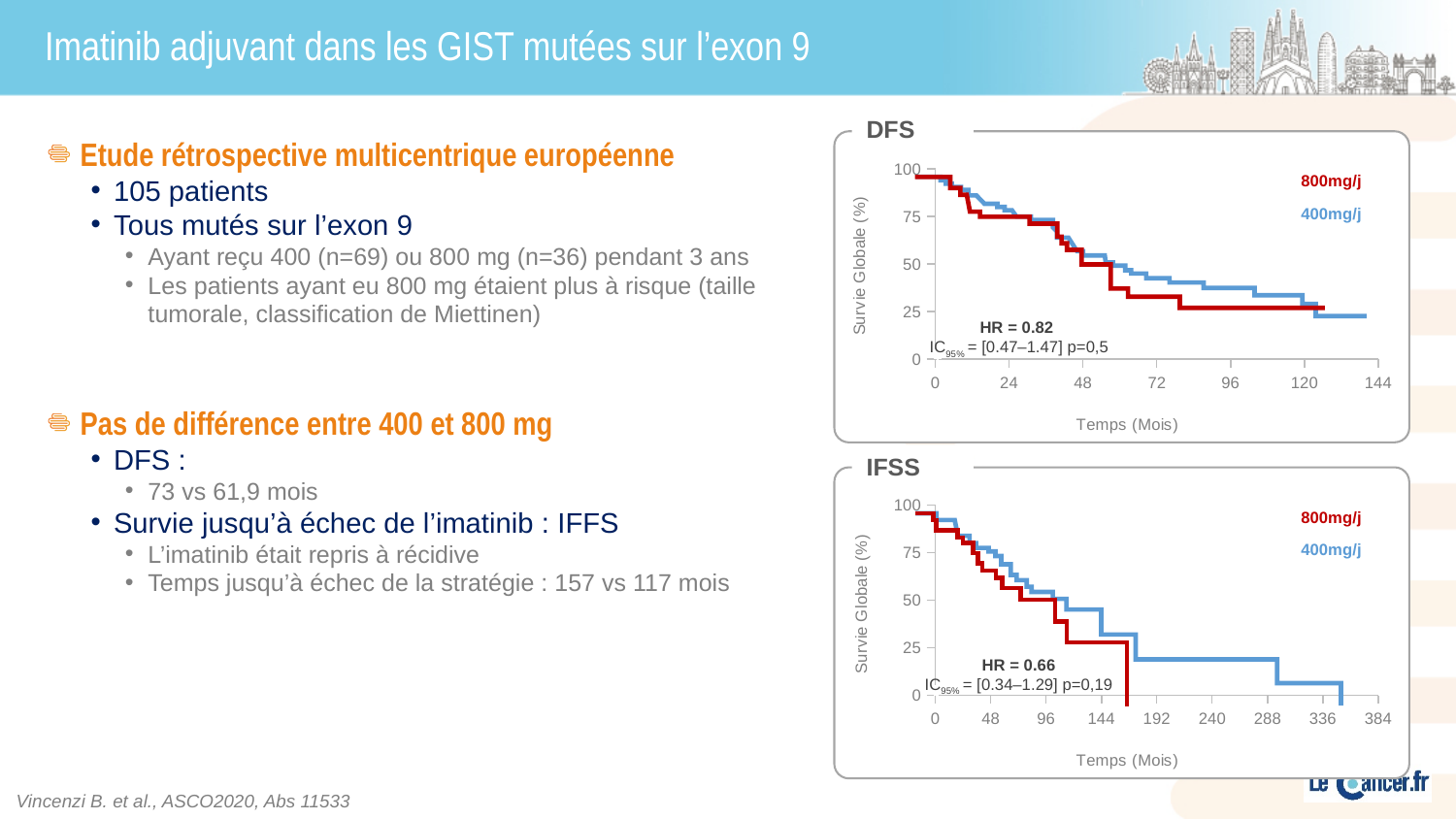
What is the maximum value shown on the x axis of the IFSS chart? 384 In the DFS chart, at 96 months, which series has the higher survival value, 400mg/j or 800mg/j? 400mg/j How many series are shown in the legend of the IFSS chart? 2 In the DFS chart, do the survival curves rise or fall as time increases? fall What kind of chart is the DFS chart? line chart (Kaplan-Meier survival curves) In the IFSS chart, is the 400mg/j value at 192 months greater or less than 25? less In the DFS chart, is the 400mg/j value at 96 months greater or less than 50? less In the DFS chart, which series is drawn in red? 800mg/j In the IFSS chart, is the 400mg/j value at 48 months greater or less than 50? greater What is the hazard ratio printed on the DFS chart? HR = 0.82 In the IFSS chart, at 192 months, which series has the higher survival value, 400mg/j or 800mg/j? 400mg/j